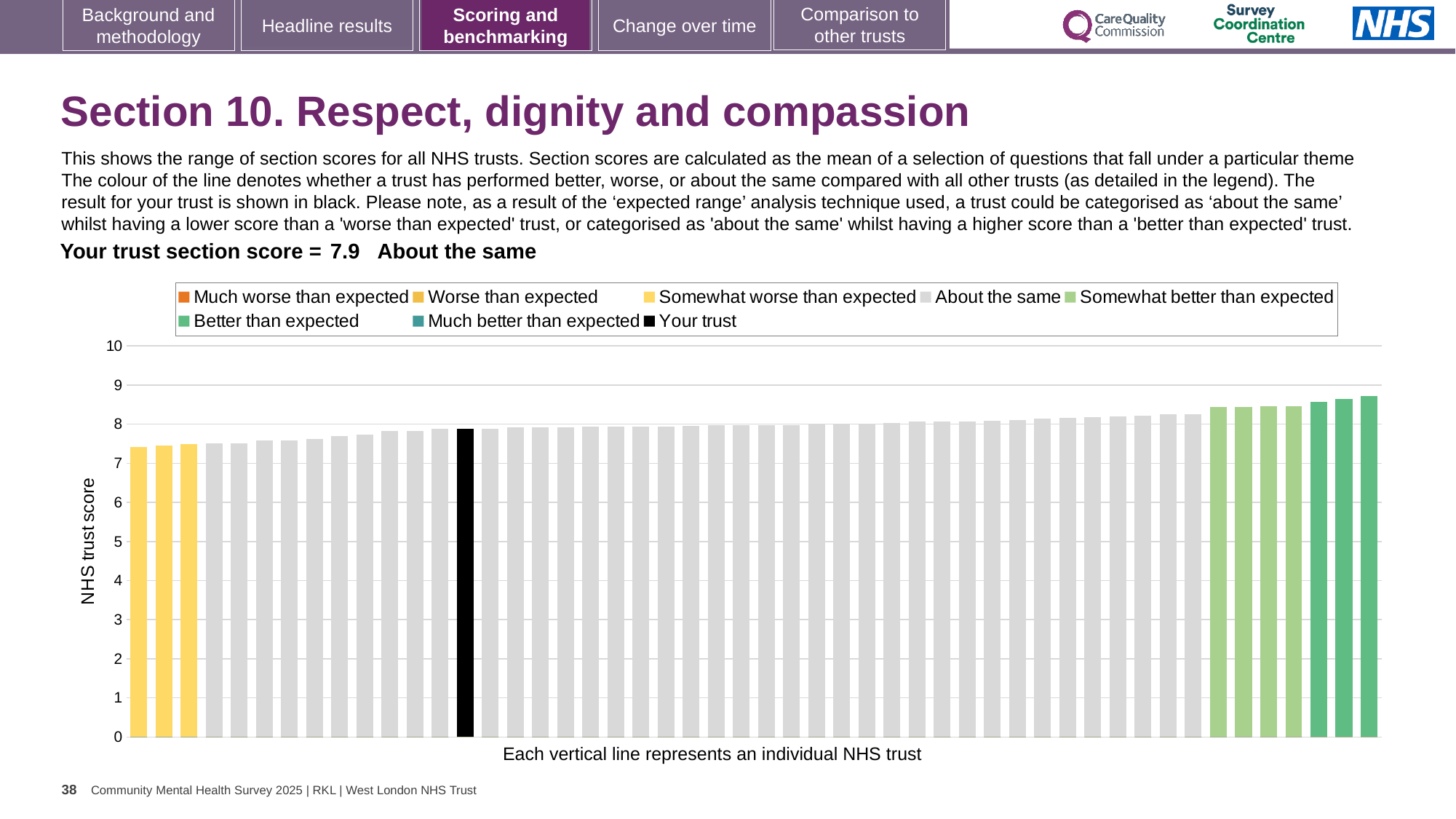
Is the value for the highest-scoring trust greater or less than 8? greater What kind of chart is shown on the slide? bar chart What is your trust's section score for Section 10, Respect, dignity and compassion? 7.9 How many bars are coloured as 'Somewhat worse than expected'? 3 How many bars are coloured green (somewhat better or better than expected)? 7 Is the value for your trust greater or less than 7? greater How many entries does the chart legend list? 8 Do the bar values rise or fall from left to right along the x axis? rise Is the value for the lowest-scoring trust greater or less than 8? less Which category is your trust placed in for Section 10? About the same What is the label on the vertical axis of the chart? NHS trust score What colour is the bar representing your trust? black